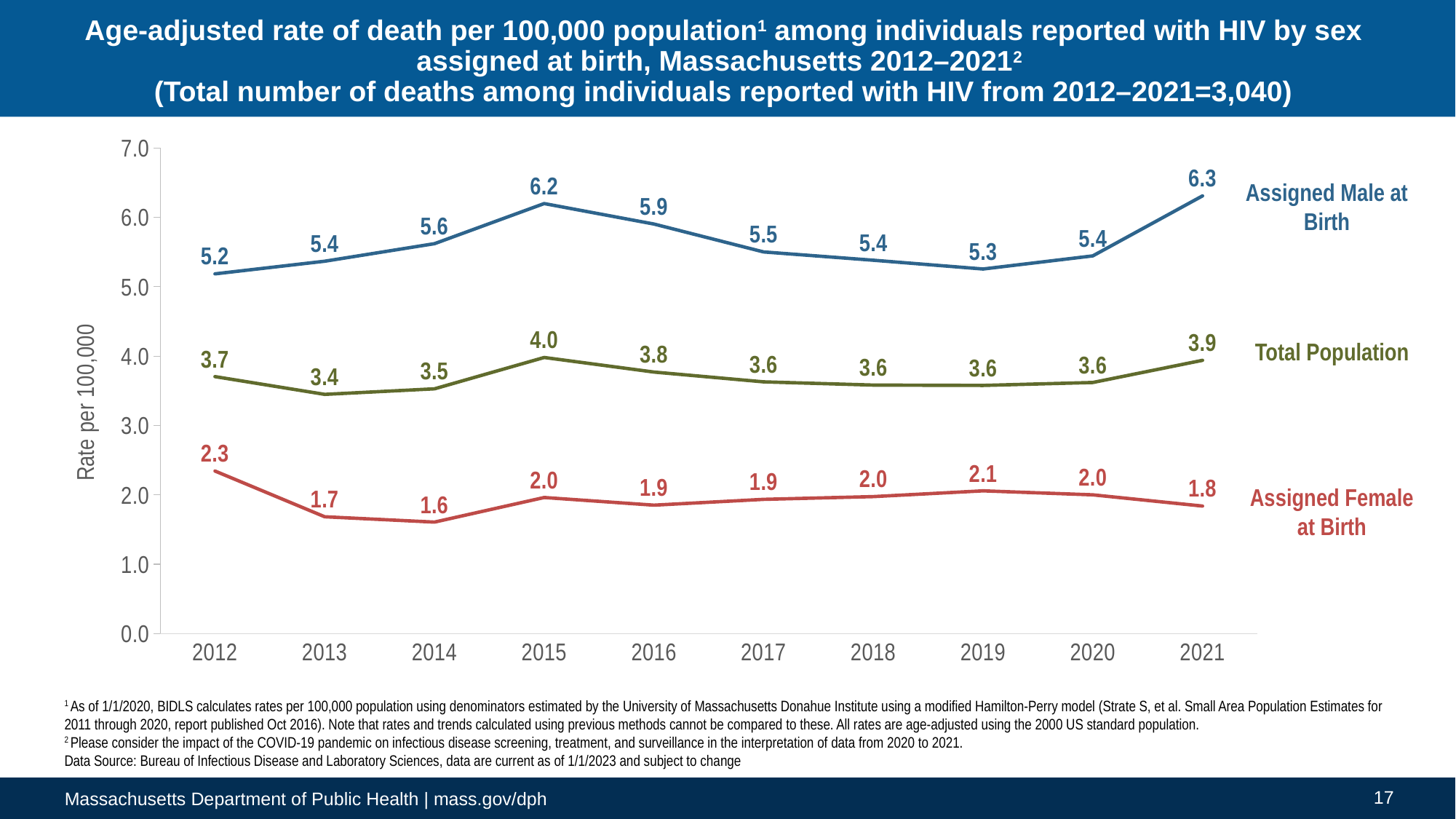
What is the Total Population death rate in 2021? 3.9 How many years are shown on the x axis? 10 What kind of chart is shown on the slide? line chart Which is larger, the Total Population rate in 2015 or in 2016? 2015 In which year is the Assigned Male at Birth death rate highest? 2021 Is the Assigned Male at Birth rate in 2019 greater or less than 6.0? less What is the age-adjusted death rate for Assigned Female at Birth in 2014? 1.6 What is the difference between the Assigned Male at Birth and Assigned Female at Birth death rates in 2021? 4.5 What is the label of the y axis? Rate per 100,000 How many series are plotted on the chart? 3 What is the age-adjusted death rate for Assigned Male at Birth in 2015? 6.2 In which year is the Assigned Female at Birth death rate lowest? 2014